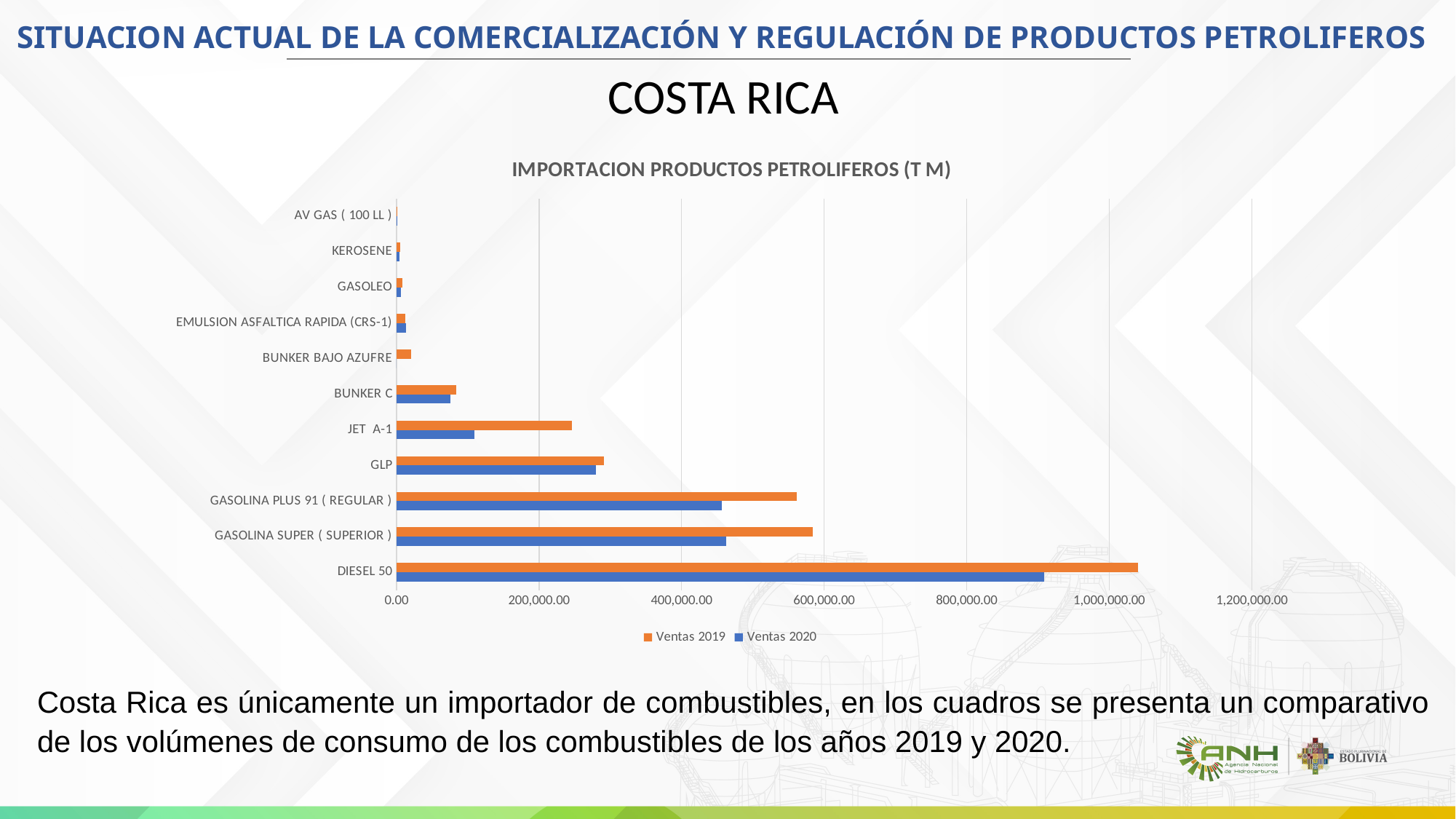
Is the Ventas 2019 value for DIESEL 50 greater or less than 1,000,000.00? greater Is the Ventas 2020 value for GASOLINA PLUS 91 ( REGULAR ) greater or less than 400,000.00? greater Which product has the lowest Ventas 2019 value? AV GAS ( 100 LL ) Is the Ventas 2019 value for JET A-1 greater or less than 200,000.00? greater Which product has the highest Ventas 2020 value? DIESEL 50 What is the title of the chart? IMPORTACION PRODUCTOS PETROLIFEROS (T M) Which product has the highest Ventas 2019 value? DIESEL 50 What kind of chart is shown on the slide? bar chart How many product categories are plotted on the chart? 11 For JET A-1, which is larger: Ventas 2019 or Ventas 2020? Ventas 2019 How many series does the legend list? 2